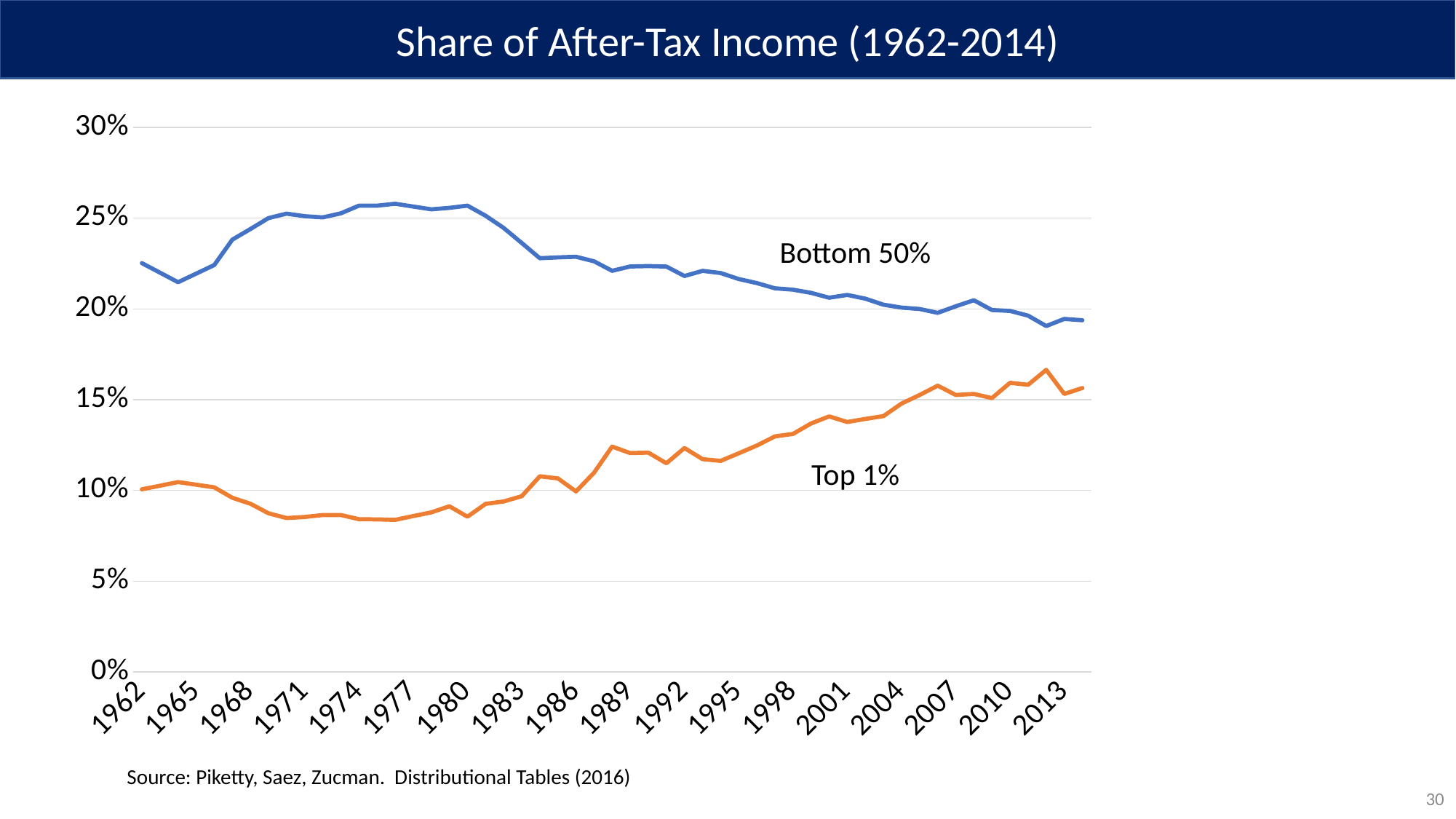
Is the value for Top 1% in 1989 greater or less than 10%? greater How many series are plotted on the chart? 2 Is the value for Bottom 50% in 1962 greater or less than 20%? greater What kind of chart is shown on the slide? Line chart Does the Bottom 50% line rise or fall overall from 1962 to 2014? Fall Is the value for Bottom 50% in 2013 greater or less than 20%? less Does the Top 1% line rise or fall overall from 1962 to 2014? Rise What is the title of the chart? Share of After-Tax Income (1962-2014) How many year labels are shown on the x axis? 18 Which series has the higher share in 1962, Bottom 50% or Top 1%? Bottom 50% What colour is the line for Top 1%? Orange